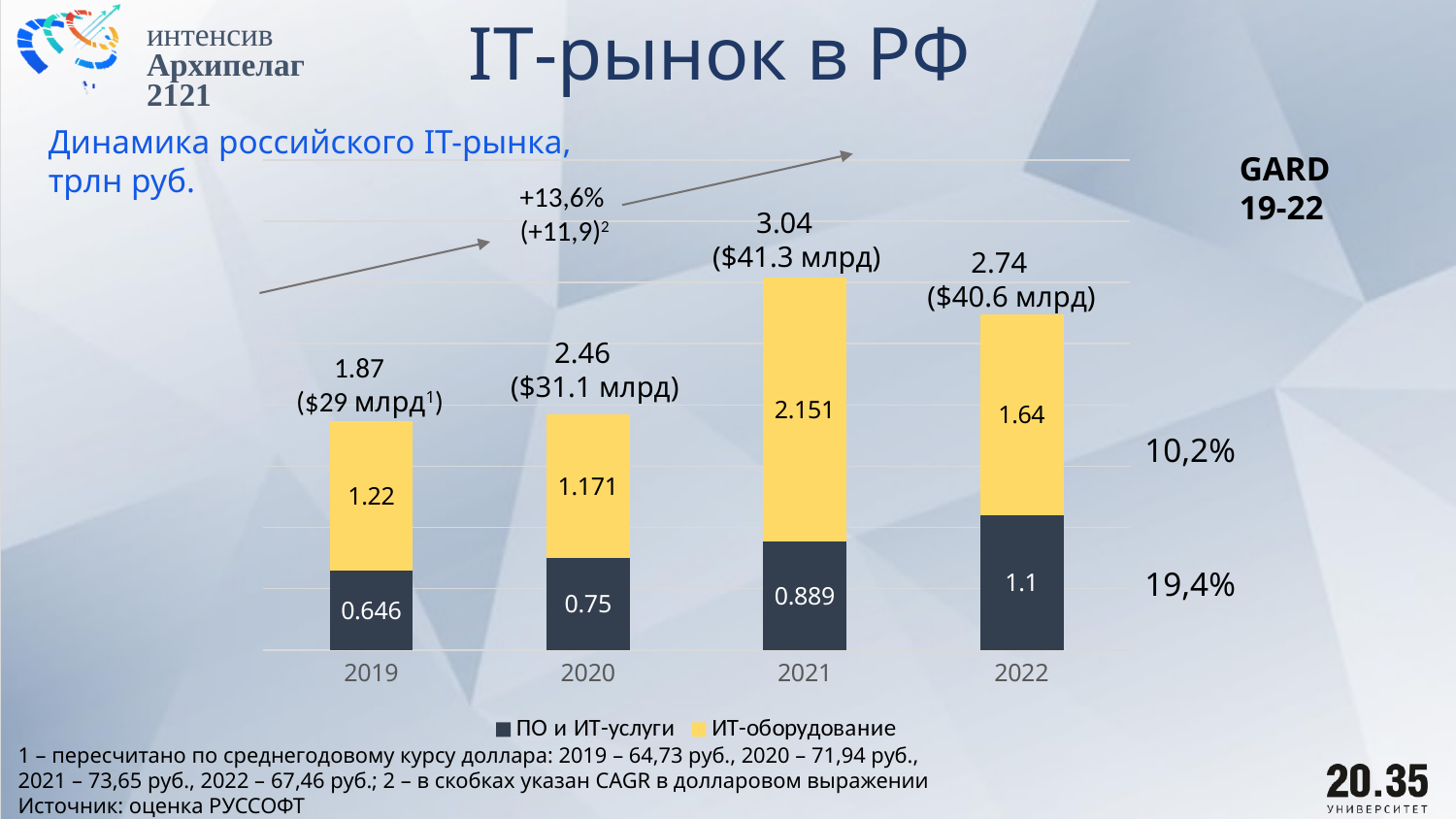
What is the value for ИТ-оборудование in 2021? 2.151 What is the total value of the stacked bar for 2020? 2.46 Which is larger: the ПО и ИТ-услуги value in 2020 or in 2021? 2021 What is the difference between the ИТ-оборудование values for 2021 and 2022? 0.511 What is the value for ПО и ИТ-услуги in 2019? 0.646 What is the value for ПО и ИТ-услуги in 2022? 1.1 Which year has the lowest value for ИТ-оборудование? 2020 Does the ПО и ИТ-услуги value rise or fall from 2019 to 2022? Rise How many series does the legend list? 2 How many years are shown on the x axis? 4 Which year has the highest total value? 2021 What type of chart is shown on the slide? Stacked bar chart